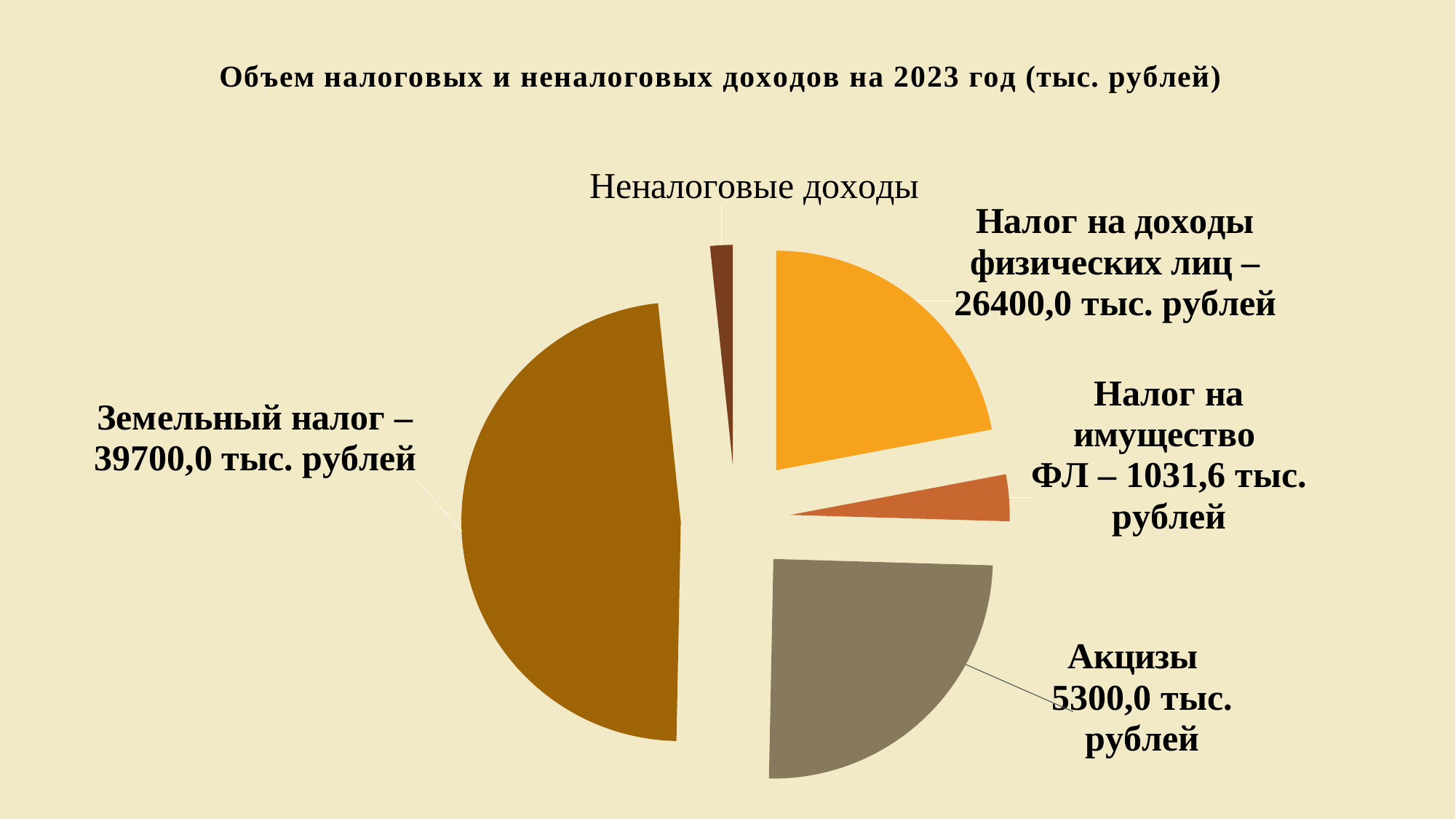
What is the value for Налог на доходы физических лиц? 26400,0 тыс. рублей Which is larger, Акцизы or Налог на имущество ФЛ? Акцизы What kind of chart is shown on the slide? pie chart What is the difference between Земельный налог and Налог на доходы физических лиц? 13300,0 тыс. рублей Which category has the smallest slice of the pie? Неналоговые доходы How many slices does the pie chart have? 5 What is the value for Налог на имущество ФЛ? 1031,6 тыс. рублей Which category has the largest slice of the pie? Земельный налог What is the value for Земельный налог? 39700,0 тыс. рублей What is the value for Акцизы? 5300,0 тыс. рублей What is the title of the chart? Объем налоговых и неналоговых доходов на 2023 год (тыс. рублей) Which slice is labelled without a numeric value? Неналоговые доходы